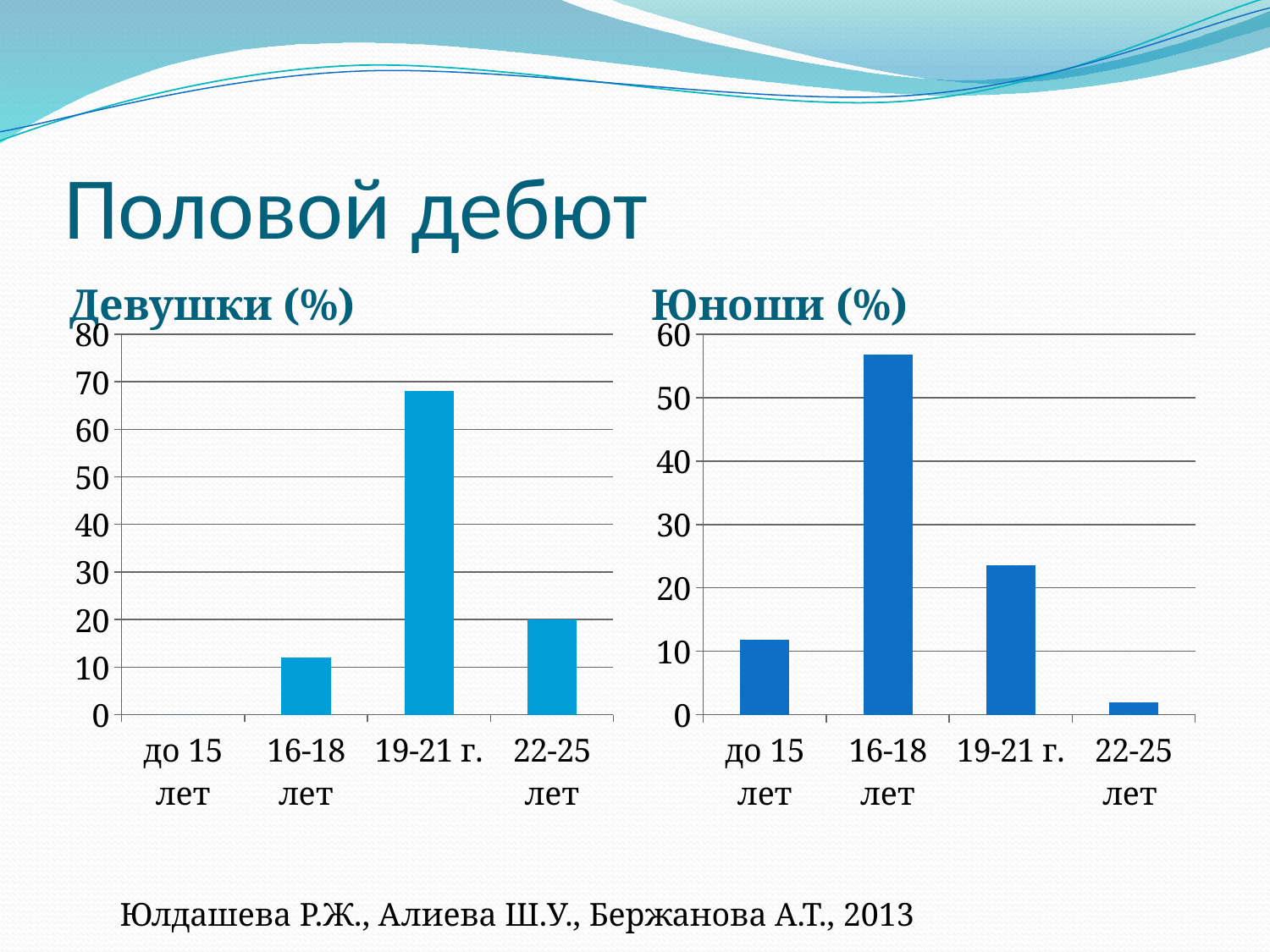
What kind of chart is the "Девушки (%)" chart? bar chart In the "Девушки (%)" chart, which age category has the highest value? 19-21 г. In the "Юноши (%)" chart, which is larger: the value for до 15 лет or the value for 19-21 г.? 19-21 г. In the "Юноши (%)" chart, which age category has the lowest value? 22-25 лет How many age categories are shown on the "Юноши (%)" chart? 4 In the "Юноши (%)" chart, is the value for 19-21 г. greater or less than 30? less In the "Девушки (%)" chart, is the value for 19-21 г. greater or less than 60? greater In the "Девушки (%)" chart, which age category has the lowest value? до 15 лет What is the title of the chart on the right side of the slide? Юноши (%) In the "Юноши (%)" chart, is the value for 16-18 лет greater or less than 50? greater In the "Девушки (%)" chart, which is larger: the value for 16-18 лет or the value for 22-25 лет? 22-25 лет In the "Юноши (%)" chart, which age category has the highest value? 16-18 лет